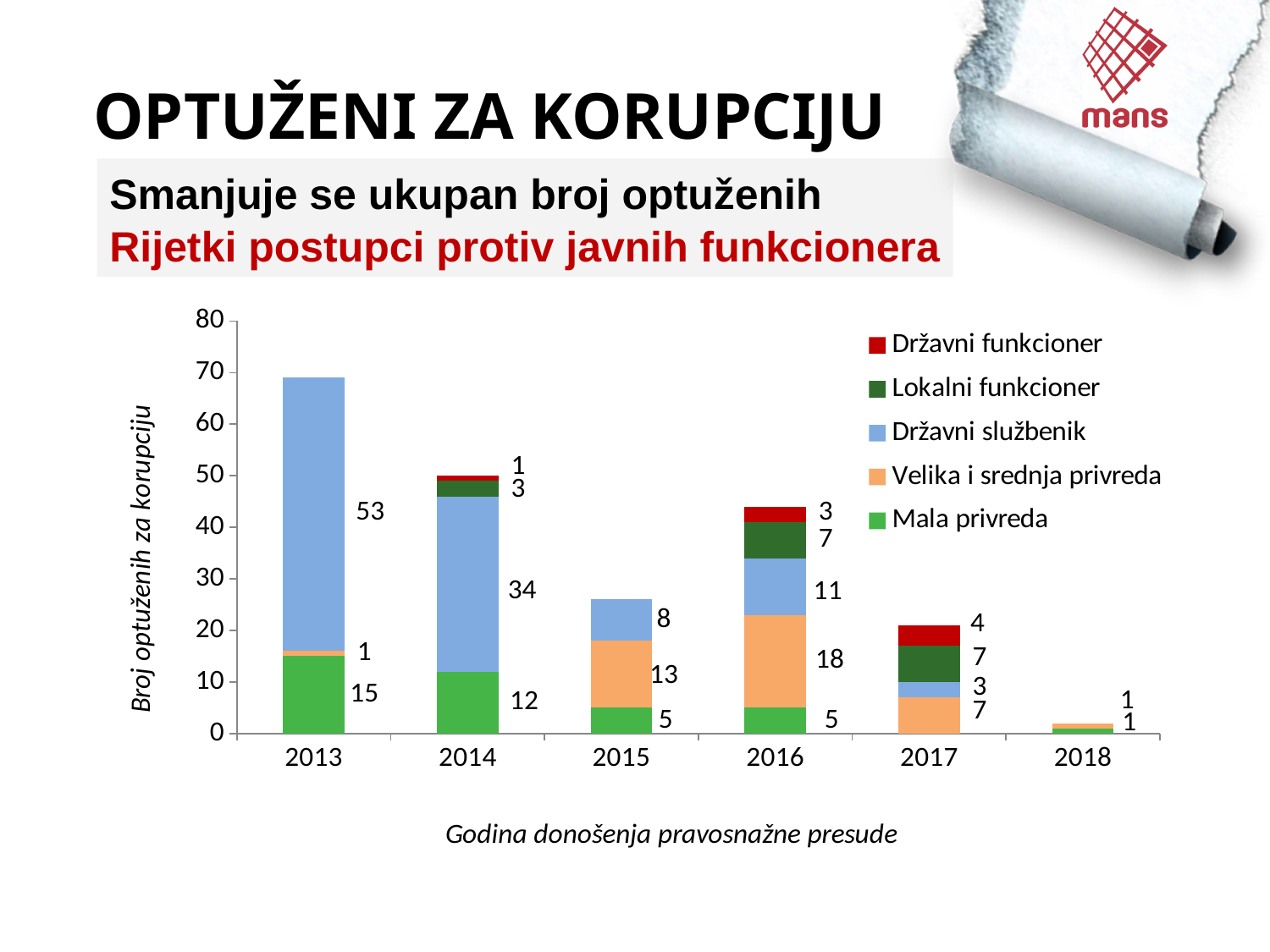
What is the value for Državni funkcioner in 2017? 4 What is the difference between the Državni službenik values for 2013 and 2014? 19 How many series does the legend list? 5 Which is larger: Velika i srednja privreda in 2015 or Državni službenik in 2015? Velika i srednja privreda in 2015 Which year has the tallest stacked bar? 2013 What is the value for Velika i srednja privreda in 2016? 18 What is the value for Mala privreda in 2014? 12 What is the total of the stacked bar for 2016? 44 Which year has the shortest stacked bar? 2018 How many years are shown on the x axis? 6 What is the total of the stacked bar for 2015? 26 What is the value for Državni službenik in 2013? 53